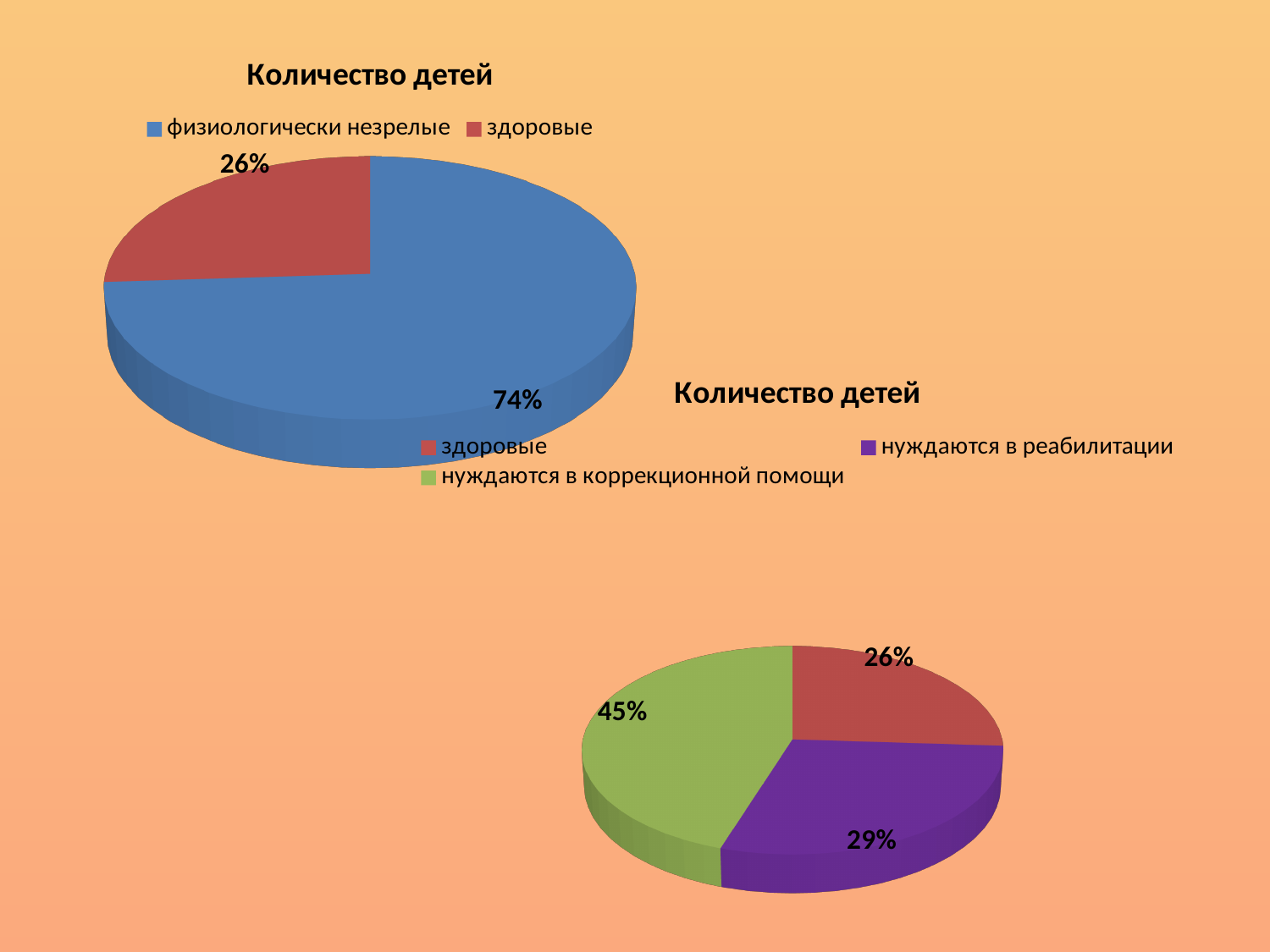
In the top-left pie chart, what share is labelled for физиологически незрелые? 74% In the bottom-right pie chart, which category has the smallest slice? здоровые In the bottom-right pie chart, which is larger: нуждаются в реабилитации or здоровые? нуждаются в реабилитации In the bottom-right pie chart, what share is labelled for нуждаются в реабилитации? 29% What is the title of the bottom-right pie chart? Количество детей In the top-left pie chart, which category has the largest slice? физиологически незрелые How many categories does the legend of the bottom-right pie chart list? 3 In the top-left pie chart, what share is labelled for здоровые? 26% In the top-left pie chart, what is the difference in percentage points between физиологически незрелые and здоровые? 48 In the bottom-right pie chart, what share is labelled for нуждаются в коррекционной помощи? 45% What type of chart is the top-left chart? pie chart How many slices does the top-left pie chart have? 2